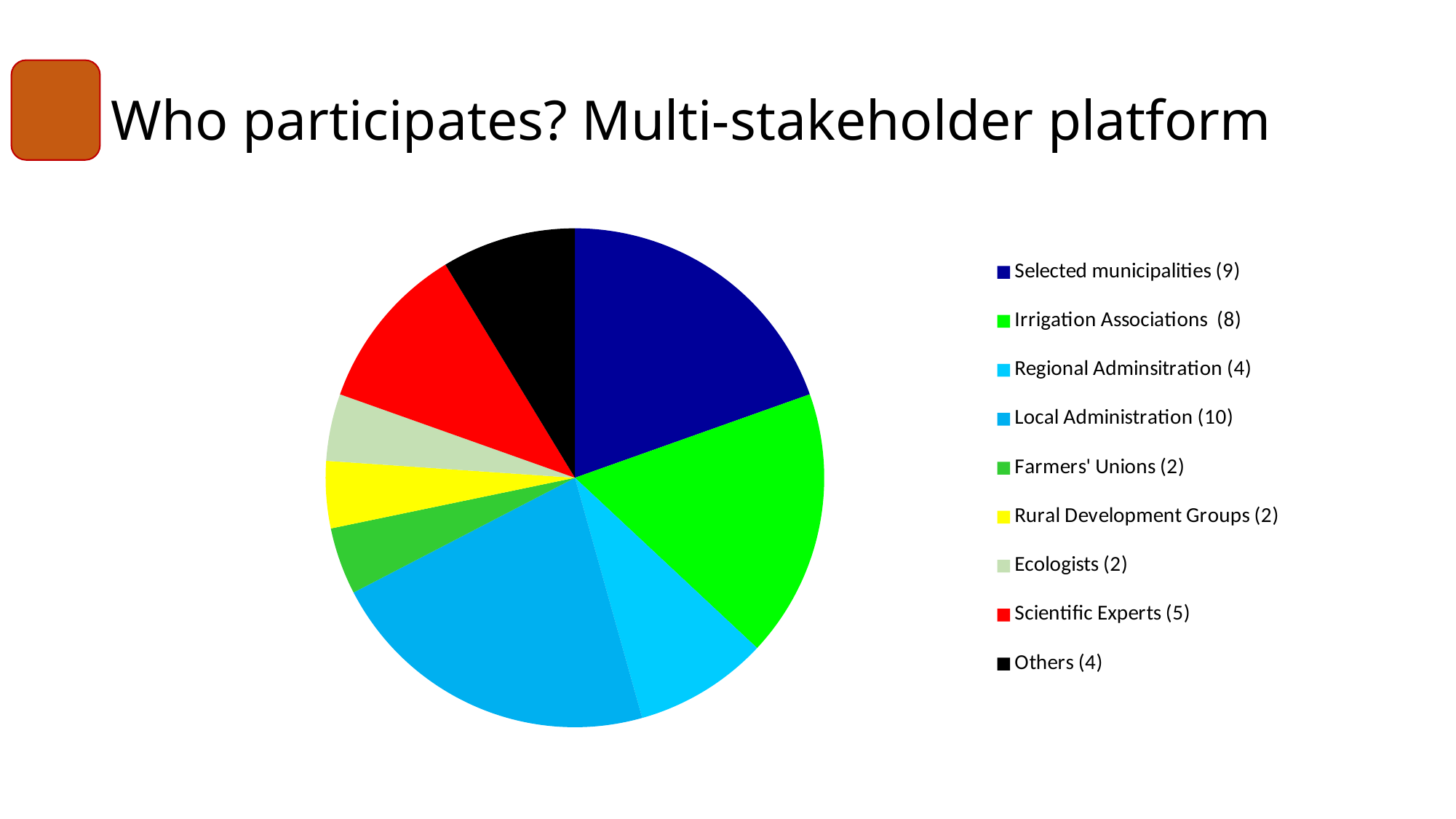
Which is larger, the value for Regional Adminsitration or the value for Farmers' Unions? Regional Adminsitration What is the difference between the values for Selected municipalities and Others? 5 What is the value for Local Administration? 10 How many categories does the pie chart show? 9 What is the difference between the values for Local Administration and Irrigation Associations? 2 What is the value for Scientific Experts? 5 What kind of chart is shown on the slide? pie chart What is the value for Selected municipalities? 9 What is the value for Ecologists? 2 Which is larger, the value for Selected municipalities or the value for Scientific Experts? Selected municipalities Which category has the largest value in the pie chart? Local Administration What colour is the slice for Scientific Experts? red